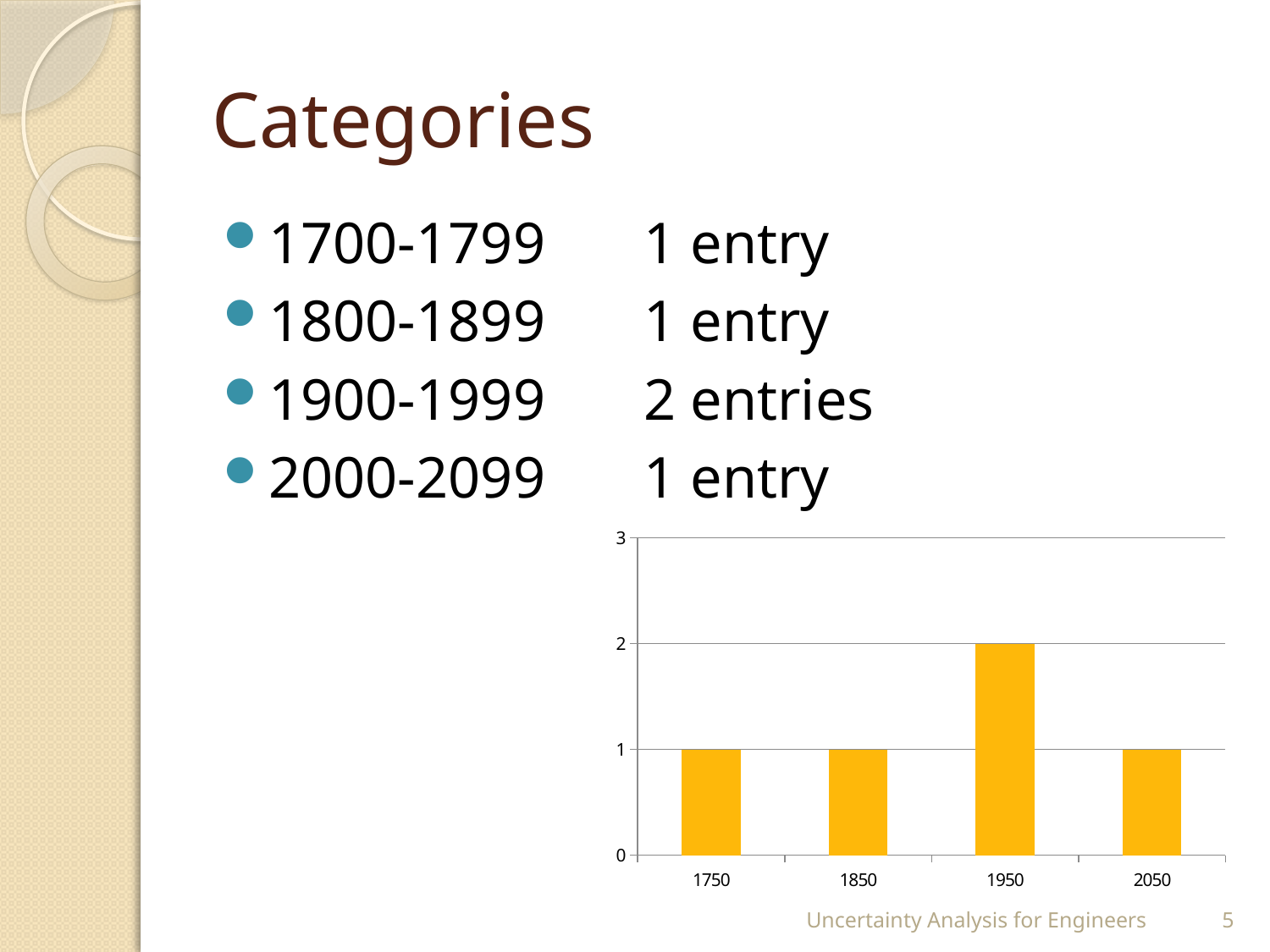
Which is larger, the value for 1950 or the value for 2050? 1950 What is the total of all four bar values in the chart? 5 What is the highest value shown on the vertical axis? 3 Is the value for 1950 greater or less than 3? less What type of chart is shown on the slide? bar chart How many bars (categories) does the chart show? 4 What is the value of the bar for 1950? 2 What is the value of the bar for 2050? 1 What is the difference between the values for 1950 and 1850? 1 What colour are the bars in the chart? orange Which category has the highest bar? 1950 What is the value of the bar for 1750? 1